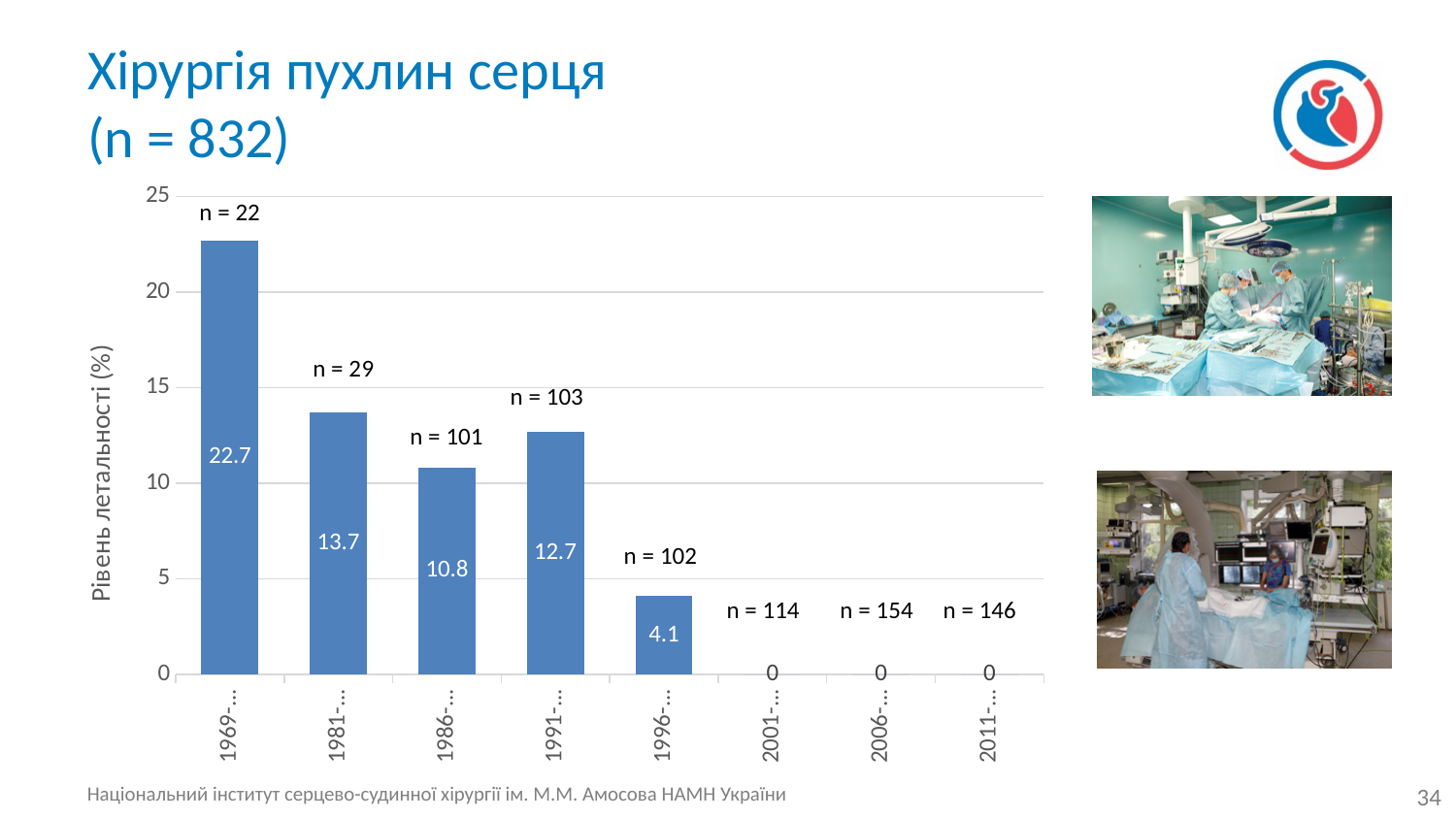
Which has a higher mortality rate: the period starting in 1986 or the period starting in 1991? 1991-... What is the mortality rate (%) for the period starting in 1986? 10.8 What is the difference in mortality rate between the period starting in 1969 and the period starting in 1981? 9.0 How many periods have a mortality rate of 0? 3 Is the mortality rate for the period starting in 1981 greater or less than 15? less What is the mortality rate (%) for the period starting in 1996? 4.1 Which period has the highest mortality rate? 1969-... How many periods (categories) are shown on the x axis? 8 What is the number of patients (n) annotated for the period starting in 2006? n = 154 What is the mortality rate (%) for the period starting in 1969? 22.7 What type of chart is shown on the slide? bar chart What is the label of the y axis? Рівень летальності (%)